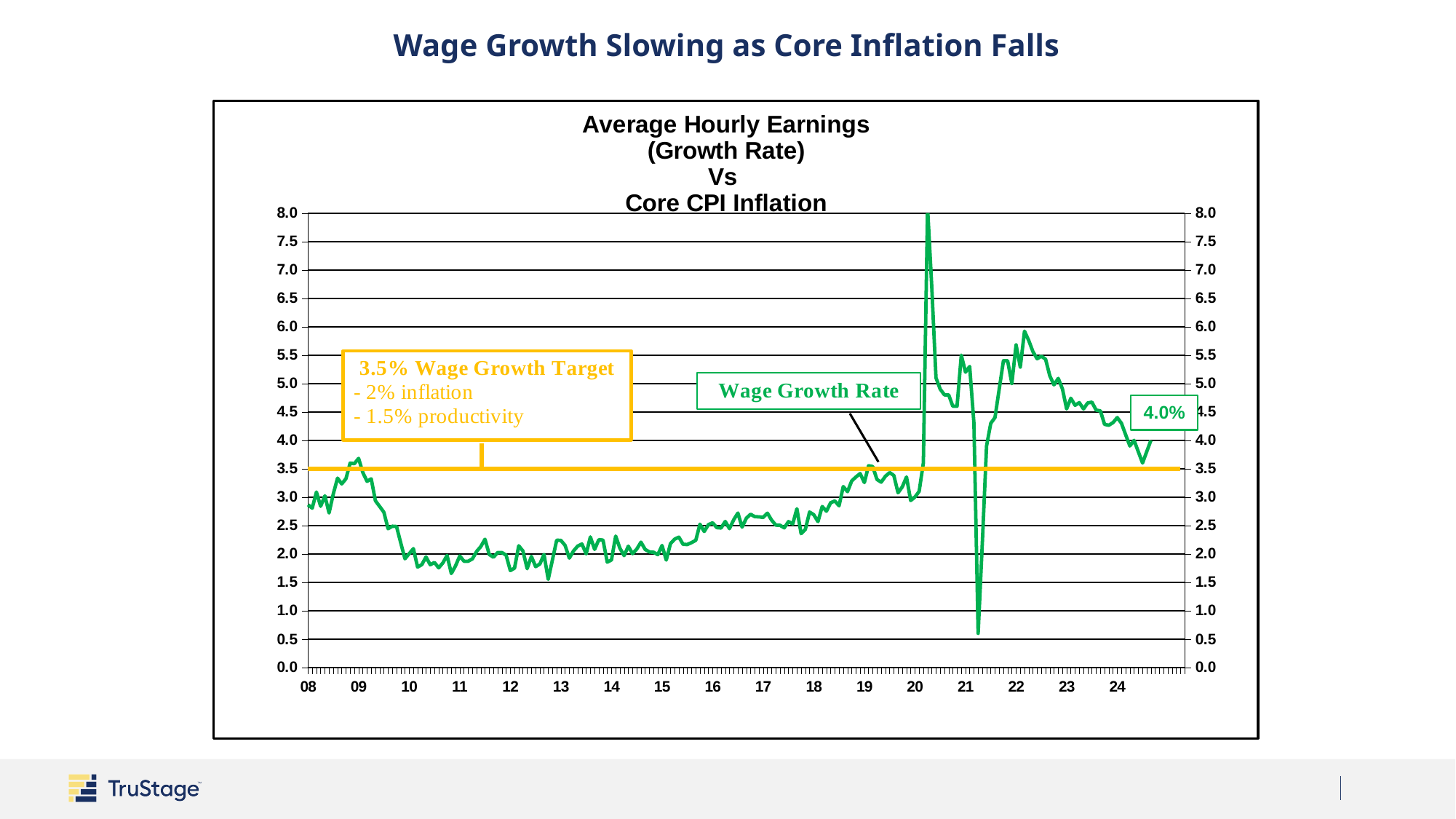
In which year does the Wage Growth Rate reach its lowest point? 21 Does the Wage Growth Rate generally rise or fall from 2022 to 2024? fall According to the annotation, what two components make up the 3.5% Wage Growth Target? 2% inflation and 1.5% productivity What is the wage growth target shown by the horizontal line? 3.5% What kind of chart is shown on the slide? line chart How many year labels are shown on the x axis? 17 Is the peak of the Wage Growth Rate in 2020 greater or less than 7.0? greater In which year does the Wage Growth Rate reach its highest point? 20 Is the lowest point of the Wage Growth Rate in 2021 greater or less than 1.0? less Does the Wage Growth Rate generally rise or fall from 2016 to 2019? rise What is the most recent value of the Wage Growth Rate labelled on the chart? 4.0% Is the Wage Growth Rate in 2010 greater or less than 2.5? less